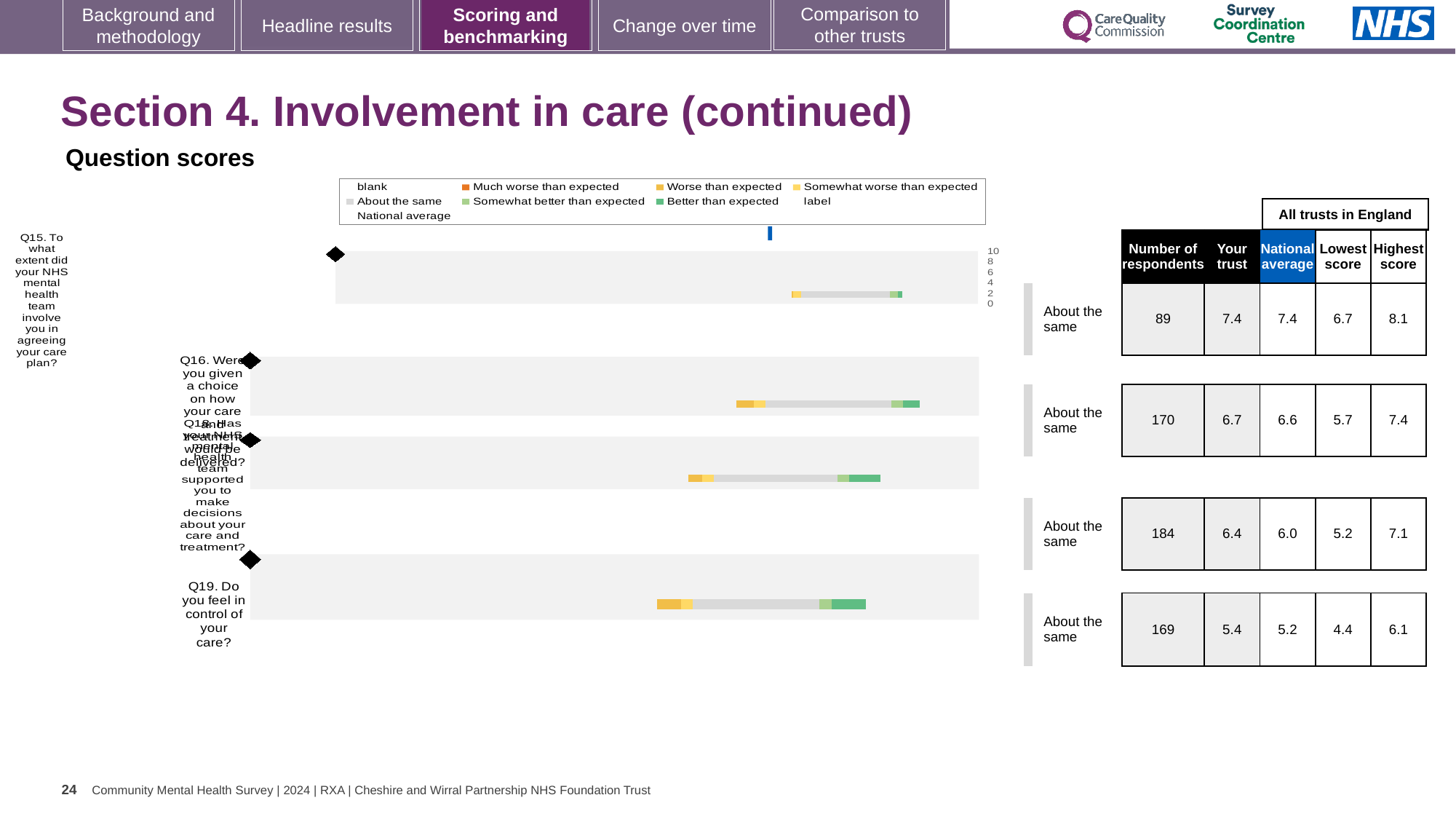
In the table beside the chart, how many respondents answered Q18? 184 In the table beside the chart, what is the highest score among all trusts in England for Q16? 7.4 In the table beside the chart, which question has the lowest 'Your trust' score? Q19 What benchmark category is shown beside the chart for Q19 (Do you feel in control of your care?)? About the same In the table beside the chart, what is the 'Your trust' score for Q15? 7.4 What kind of chart is used to show the question scores on this slide? Bar chart In the table beside the chart, is the 'Your trust' score for Q16 higher or lower than the national average? Higher How many survey questions are plotted in the question scores chart? 4 In the table beside the chart, what is the national average score for Q19? 5.2 In the table beside the chart, what is the difference between the 'Your trust' score and the national average for Q18? 0.4 In the table beside the chart, which question has the highest number of respondents? Q18 Which survey question is plotted in the top row of the question scores chart? Q15. To what extent did your NHS mental health team involve you in agreeing your care plan?